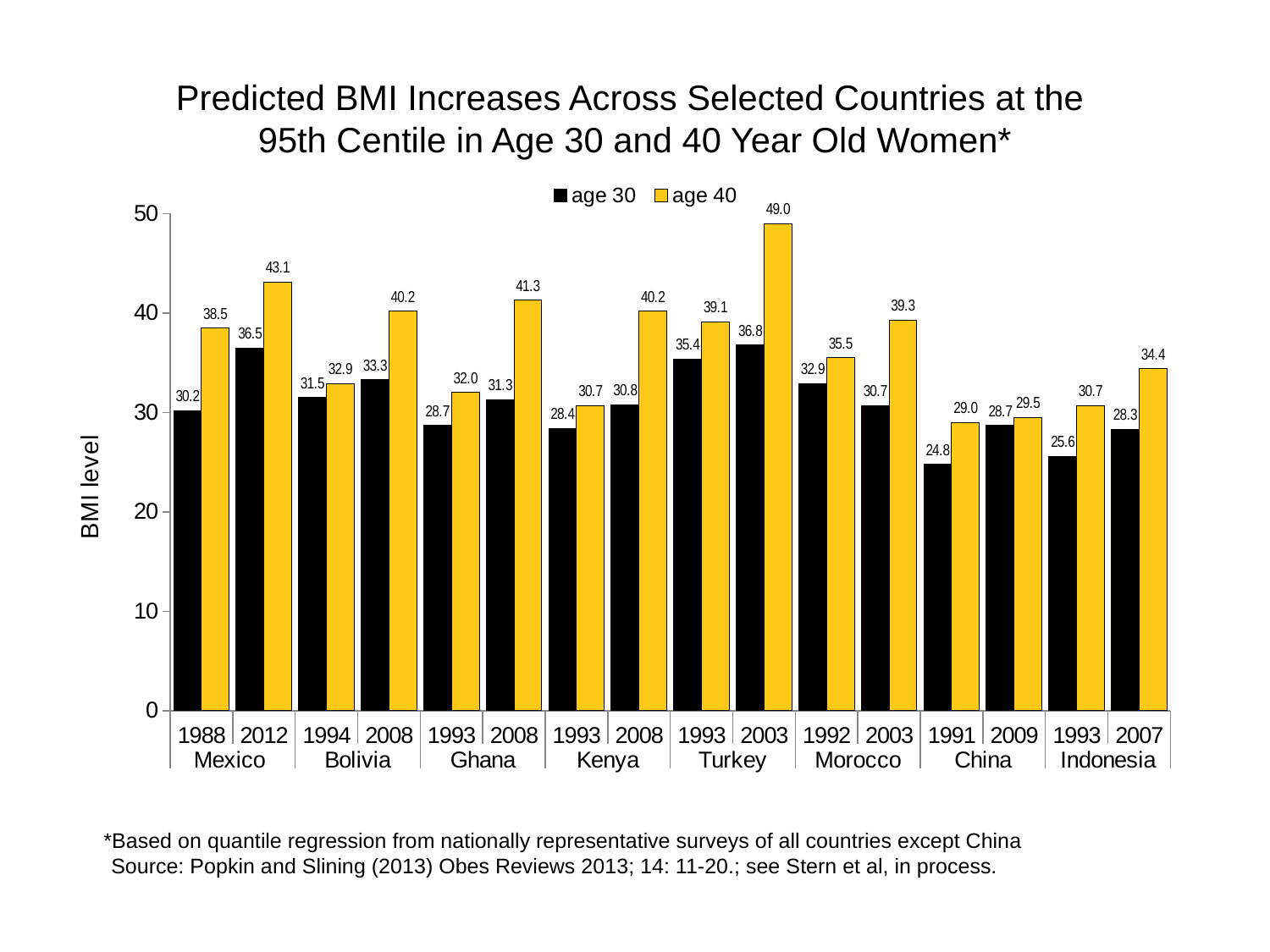
How many series does the legend list? 2 For Mexico in 2012, how much higher is the age 40 value than the age 30 value? 6.6 What is the age 40 value for Indonesia in 2007? 34.4 For China in 2009, what is the difference between the age 40 and age 30 values? 0.8 What is the predicted BMI for age 40 women in Turkey in 2003? 49.0 What kind of chart is shown on the slide? bar chart How many countries are shown on the x axis? 8 Is the age 30 value for Indonesia 1993 greater or less than 30? less Which country and year has the lowest age 30 BMI value? China 1991 What is the predicted BMI for age 30 women in China in 1991? 24.8 Which is larger: the age 40 value for Ghana 2008 or the age 40 value for Bolivia 2008? Ghana 2008 Which country and year has the highest age 40 BMI value? Turkey 2003